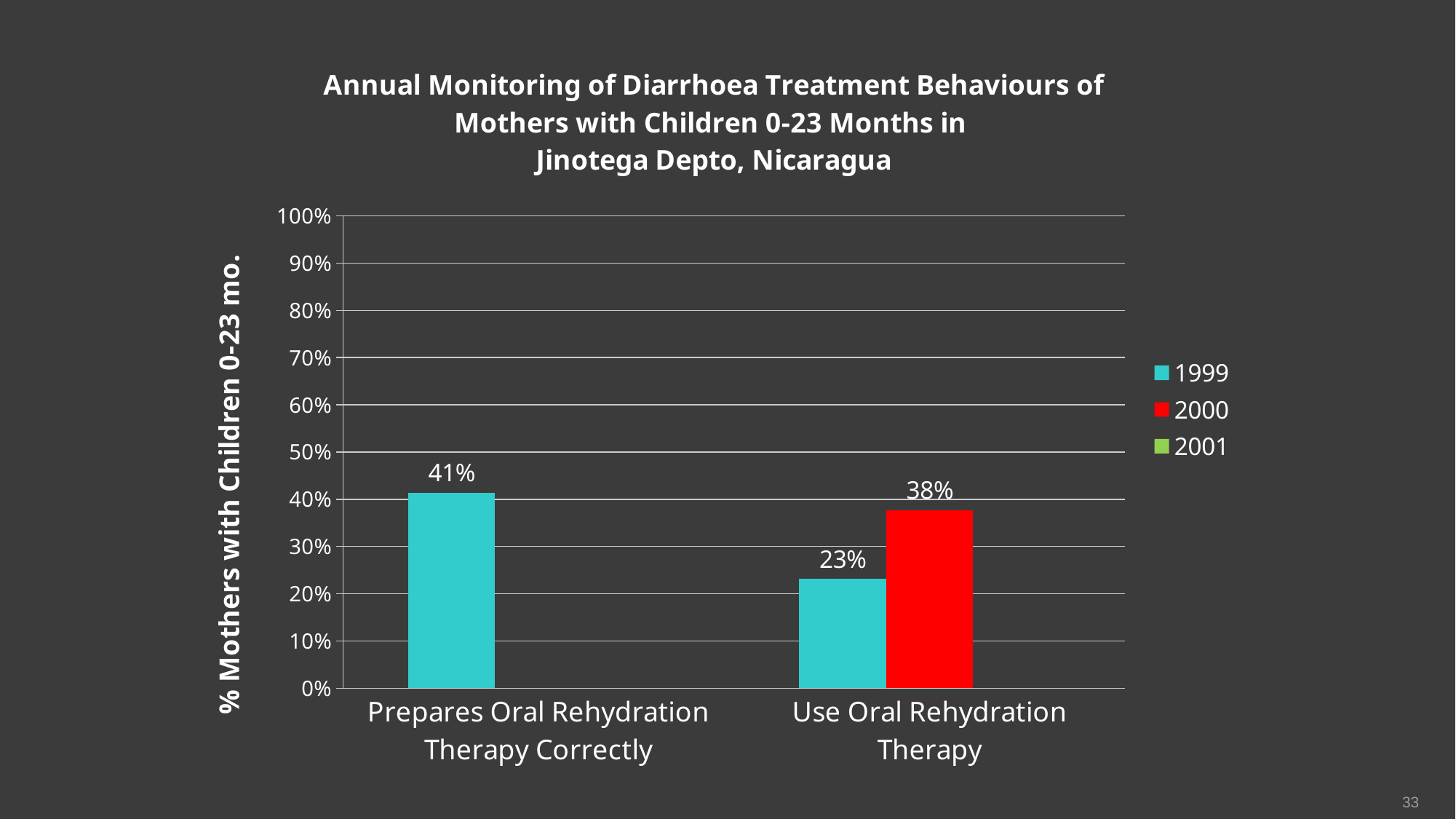
How many categories are shown on the x axis? 2 What kind of chart is shown on the slide? bar chart How many series does the legend list? 3 What is the 1999 value for Use Oral Rehydration Therapy? 23% Which category has the highest 1999 value? Prepares Oral Rehydration Therapy Correctly What is the difference between the 1999 values for Prepares Oral Rehydration Therapy Correctly and Use Oral Rehydration Therapy? 18% For Use Oral Rehydration Therapy, which year has the larger value, 1999 or 2000? 2000 For Use Oral Rehydration Therapy, what is the difference between the 2000 and 1999 values? 15% Which category has the lowest 1999 value? Use Oral Rehydration Therapy What is the 2000 value for Use Oral Rehydration Therapy? 38% What is the 1999 value for Prepares Oral Rehydration Therapy Correctly? 41% Is the 1999 value for Prepares Oral Rehydration Therapy Correctly greater or less than 50%? less